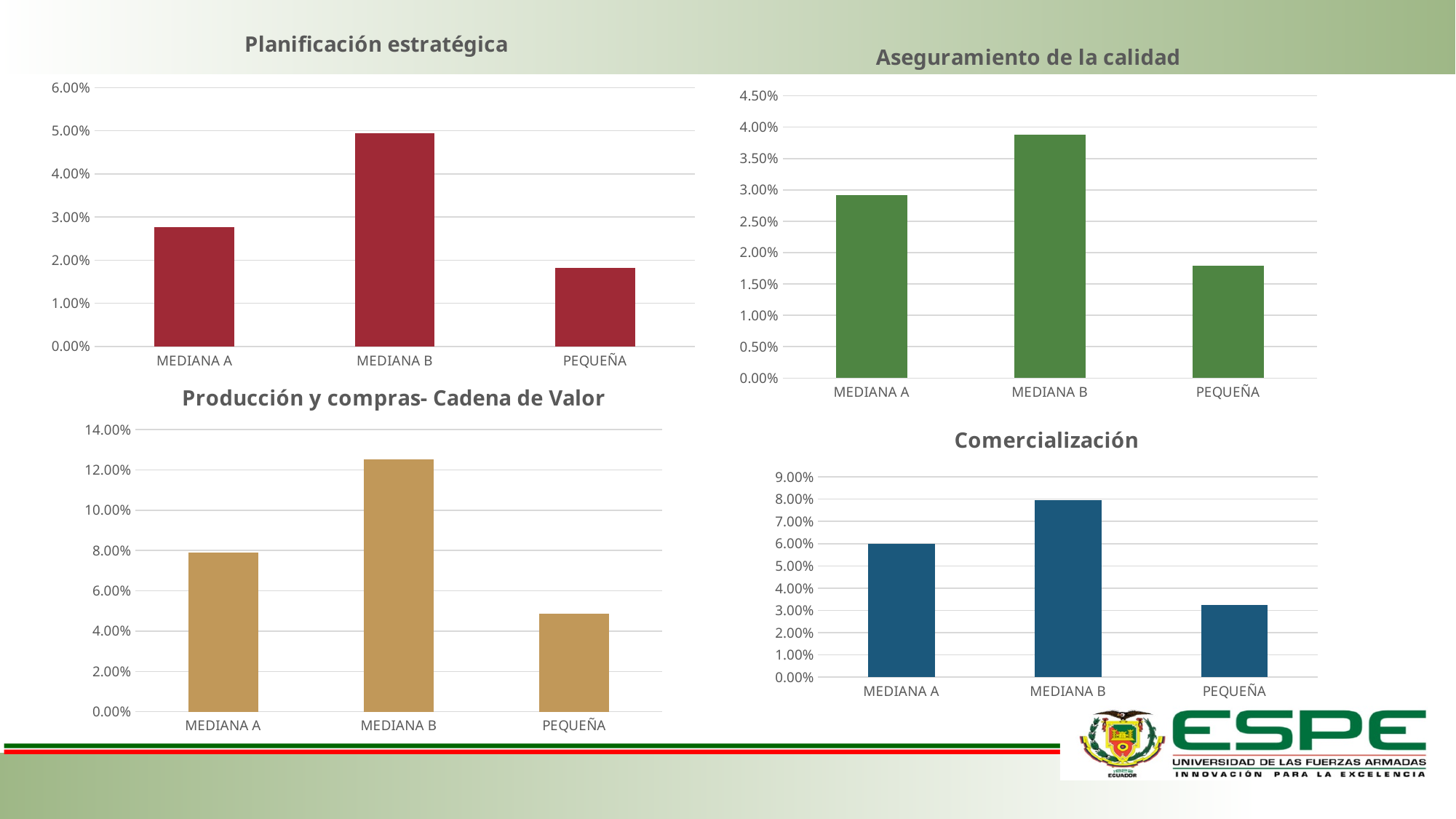
In the 'Producción y compras- Cadena de Valor' chart, which category has the highest value? MEDIANA B In the 'Comercialización' chart, which is larger, MEDIANA A or MEDIANA B? MEDIANA B In the 'Aseguramiento de la calidad' chart, which category has the lowest value? PEQUEÑA How many categories are shown in the 'Comercialización' chart? 3 In the 'Planificación estratégica' chart, is the value for PEQUEÑA greater or less than 2.00%? less In the 'Producción y compras- Cadena de Valor' chart, is the value for MEDIANA B greater or less than 12.00%? greater In the 'Planificación estratégica' chart, is the value for MEDIANA B greater or less than 4.00%? greater In the 'Aseguramiento de la calidad' chart, which is larger, MEDIANA A or PEQUEÑA? MEDIANA A In the 'Planificación estratégica' chart, which category has the highest value? MEDIANA B